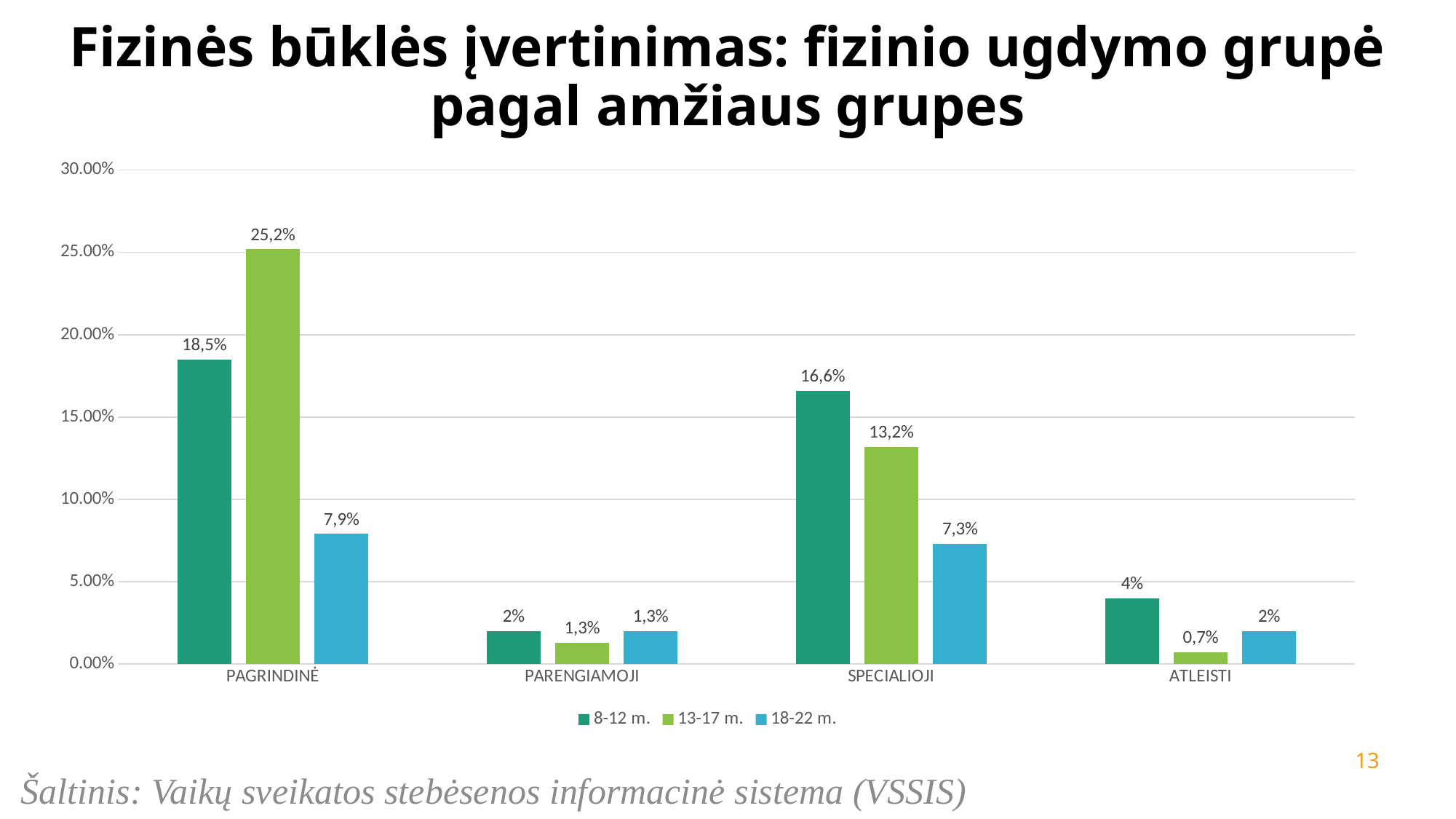
What is the difference between the 13-17 m. and 8-12 m. values in the PAGRINDINĖ category? 6,7% Which is larger in the SPECIALIOJI category: the 8-12 m. value or the 13-17 m. value? 8-12 m. Which category has the lowest value for the 8-12 m. series? PARENGIAMOJI Is the value for the 18-22 m. series in the PAGRINDINĖ category greater or less than 10.00%? less How many series does the legend list? 3 Which category has the highest value for the 13-17 m. series? PAGRINDINĖ What is the value for the 13-17 m. series in the PAGRINDINĖ category? 25,2% What is the value for the 8-12 m. series in the SPECIALIOJI category? 16,6% How many categories are shown on the x axis? 4 What is the value for the 13-17 m. series in the PARENGIAMOJI category? 1,3% What is the value for the 18-22 m. series in the ATLEISTI category? 2% What kind of chart is shown on the slide? bar chart